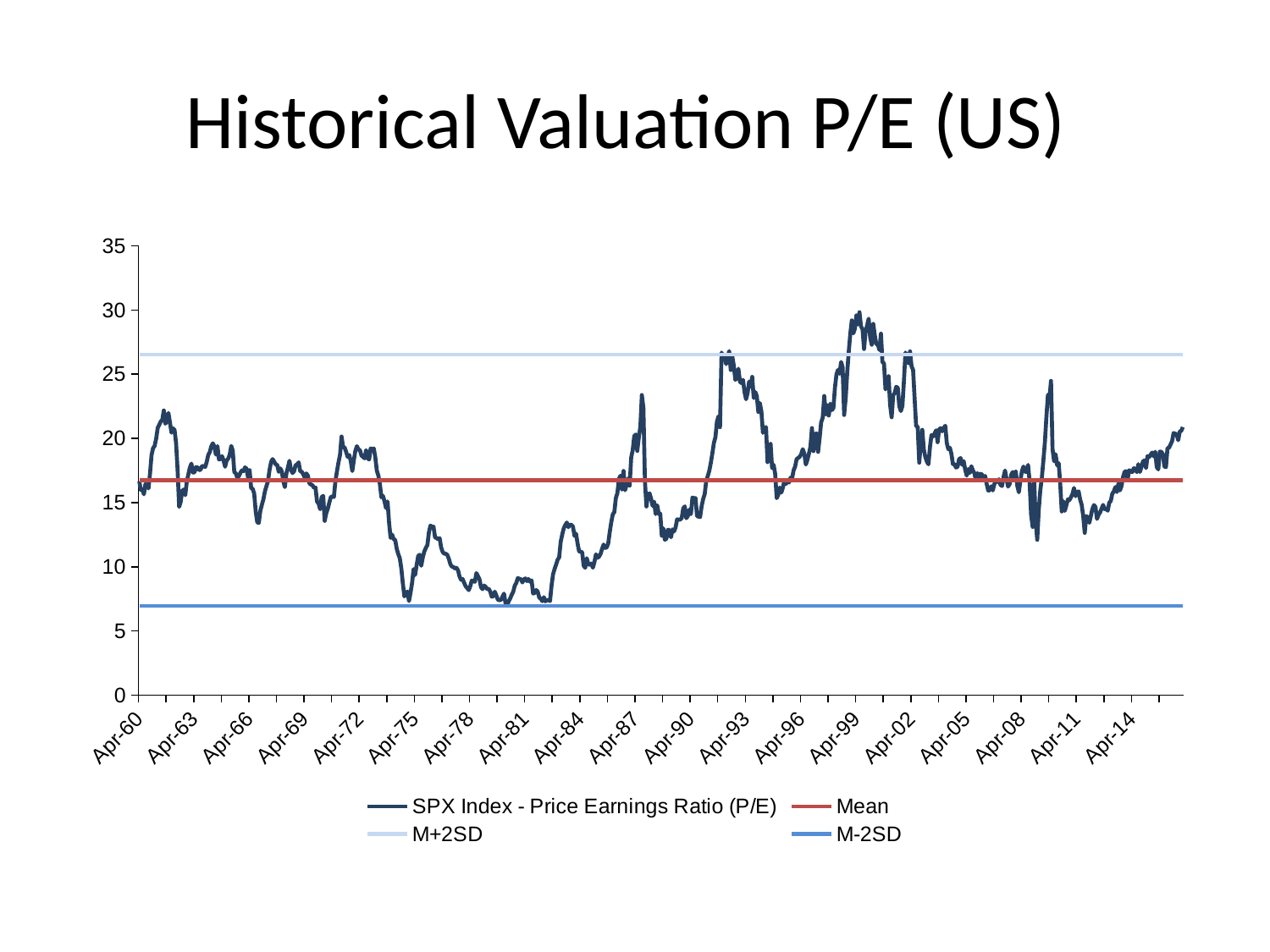
Is the peak of the SPX Index P/E around Apr-99 greater or less than 25? greater Is the Mean line greater or less than 15? greater What is the title of the chart? Historical Valuation P/E (US) Which series is drawn as the red line? Mean Does the SPX Index P/E rise or fall between Apr-72 and Apr-75? Fall Around which x-axis label does the SPX Index P/E reach its highest value? Apr-99 How many series does the legend list? 4 Is the M+2SD line greater or less than 25? greater Is the SPX Index P/E higher around Apr-99 or around Apr-78? Apr-99 What kind of chart is shown on the slide? Line chart